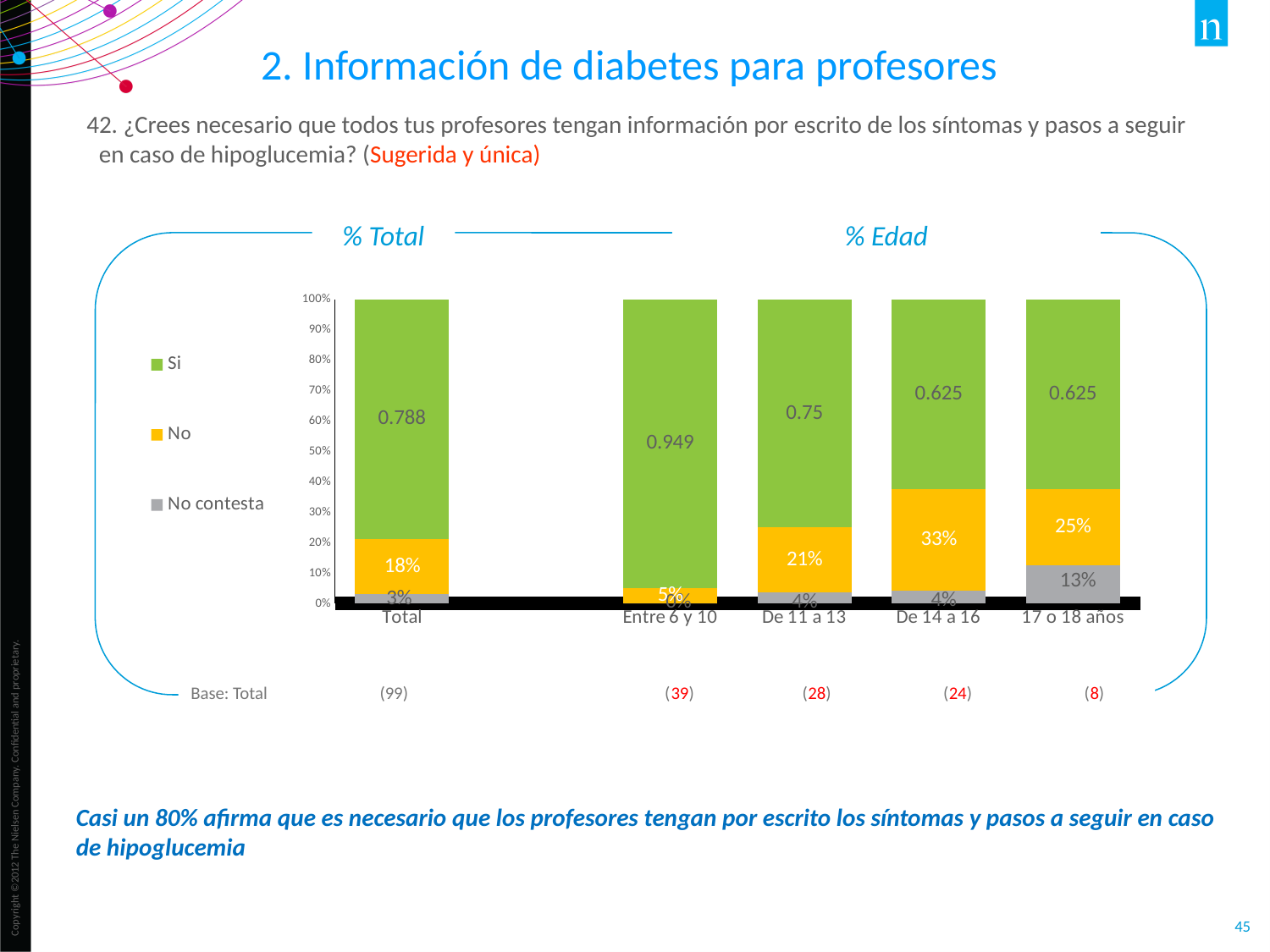
Which has a larger 'No' value: 'De 11 a 13' or 'De 14 a 16'? De 14 a 16 Which category has the highest 'No contesta' value? 17 o 18 años What is the value of the 'Si' segment for the 'Total' bar? 0.788 What is the value of the 'No contesta' segment for the 'Total' bar? 3% How many categories are shown on the x axis of the chart? 5 What is the difference between the 'No' values for 'De 14 a 16' and 'De 11 a 13'? 12 percentage points Which category has the highest 'Si' value? Entre 6 y 10 What is the value of the 'No' segment for 'De 14 a 16'? 33% What is the value of the 'Si' segment for 'Entre 6 y 10'? 0.949 What is the value of the 'No contesta' segment for '17 o 18 años'? 13% How many series does the legend list? 3 Which category has the lowest 'No' value? Entre 6 y 10